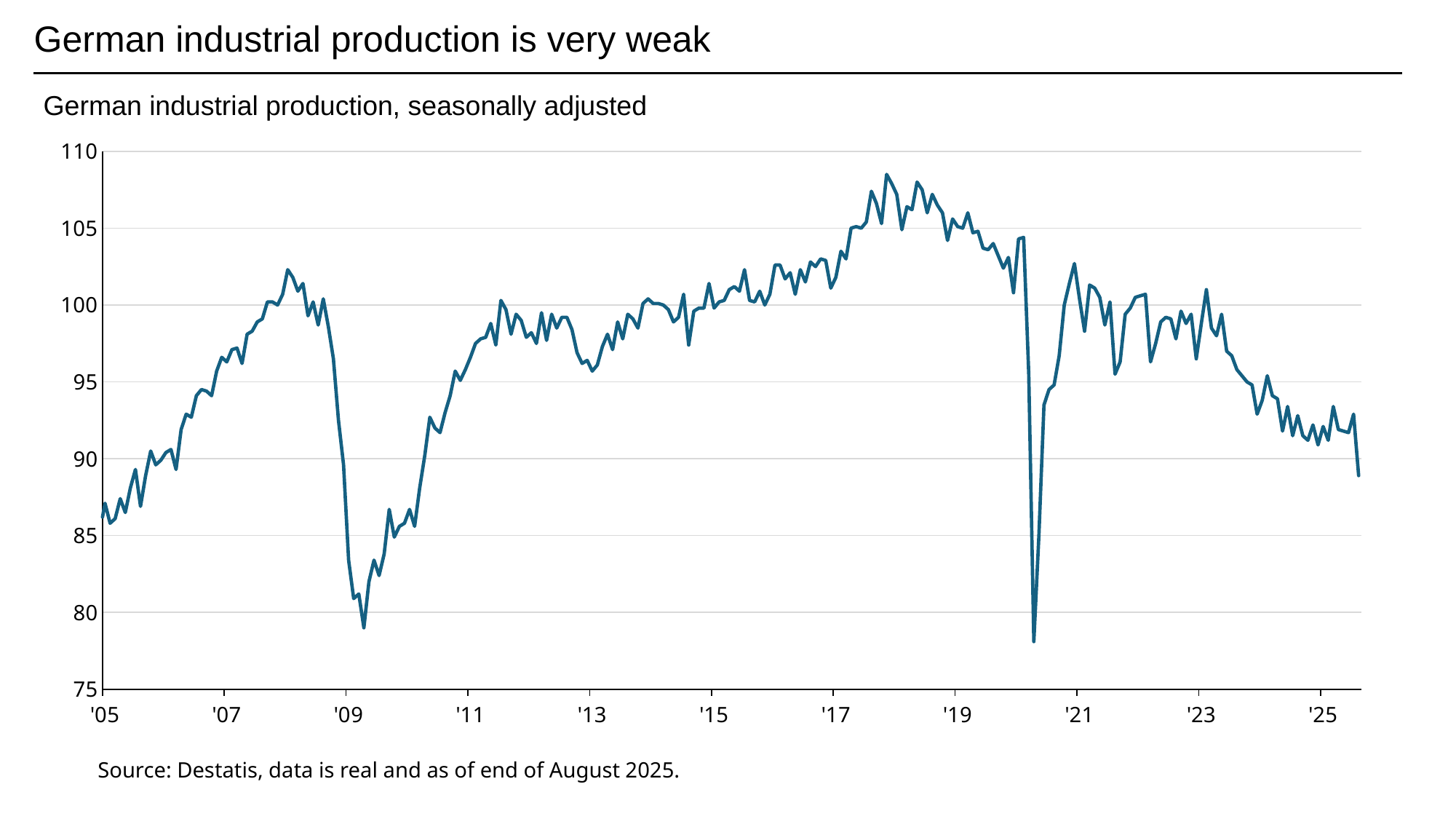
Does the line rise or fall between '23 and '25? fall Is the lowest point of the line around 2020 greater or less than 80? less What kind of chart is shown on the slide? line chart Is the value at the end of the series in 2025 greater or less than 95? less Is the value at the start of the series in '05 greater or less than 90? less Does the line rise or fall between '05 and '08? rise What is the title of the slide? German industrial production is very weak Which is higher: the peak of the line around 2008 or the peak around 2018? the peak around 2018 How many lines are plotted on the chart? 1 What is the title printed above the chart? German industrial production, seasonally adjusted